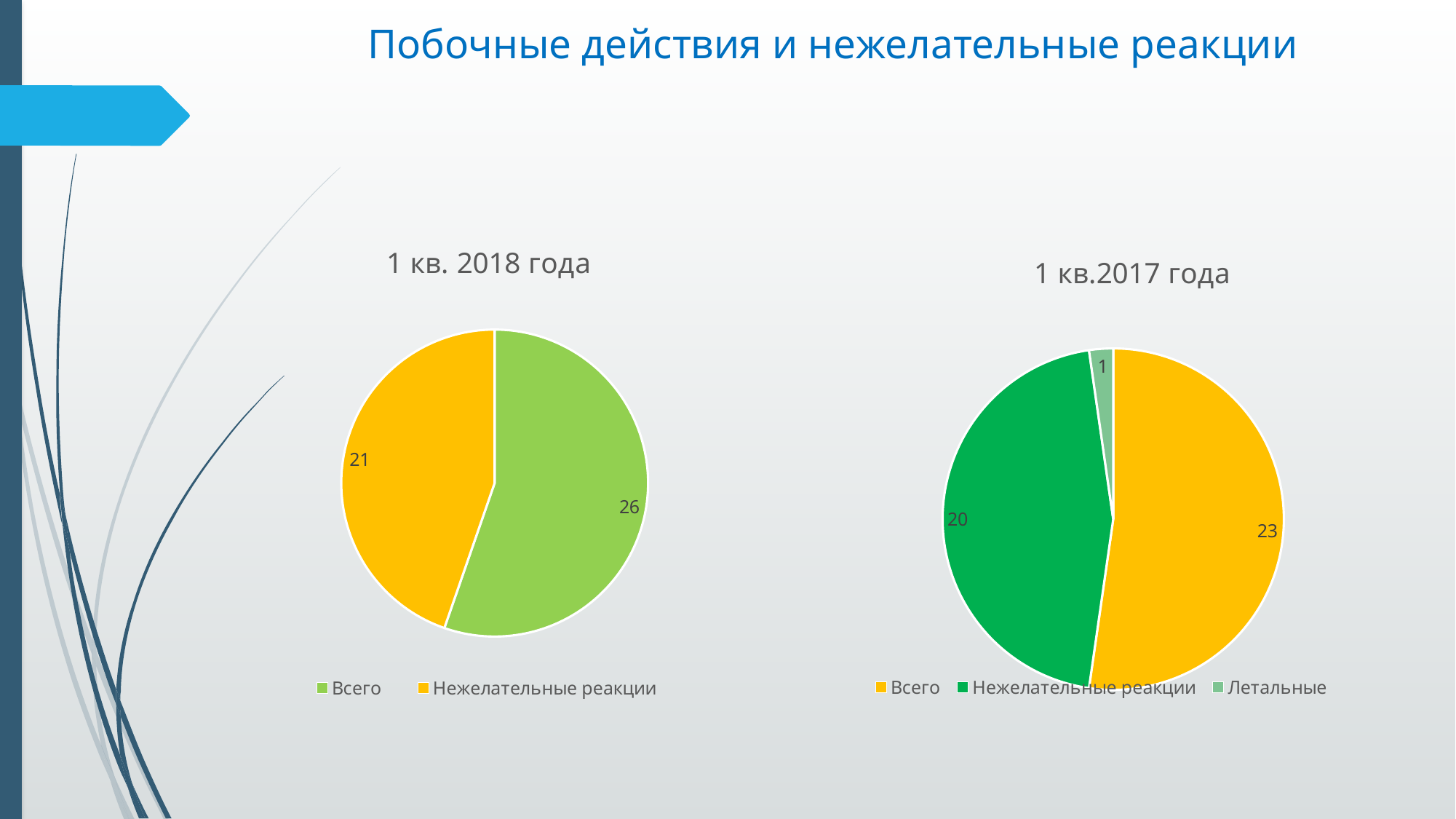
In the chart titled "1 кв.2017 года", which category has the smallest slice? Летальные Which is larger: Всего in the "1 кв. 2018 года" chart or Всего in the "1 кв.2017 года" chart? 1 кв. 2018 года In the chart titled "1 кв. 2018 года", what is the difference between Всего and Нежелательные реакции? 5 In the chart titled "1 кв.2017 года", what is the difference between Всего and Нежелательные реакции? 3 How many entries does the legend of the chart titled "1 кв. 2018 года" list? 2 What type of chart is the chart titled "1 кв. 2018 года"? Pie chart How many slices does the chart titled "1 кв.2017 года" have? 3 In the chart titled "1 кв.2017 года", what is the value for Нежелательные реакции? 20 In the chart titled "1 кв. 2018 года", what is the value for Нежелательные реакции? 21 In the chart titled "1 кв.2017 года", what is the value for Летальные? 1 In the chart titled "1 кв. 2018 года", what is the value for Всего? 26 In the chart titled "1 кв.2017 года", which category has the largest slice? Всего